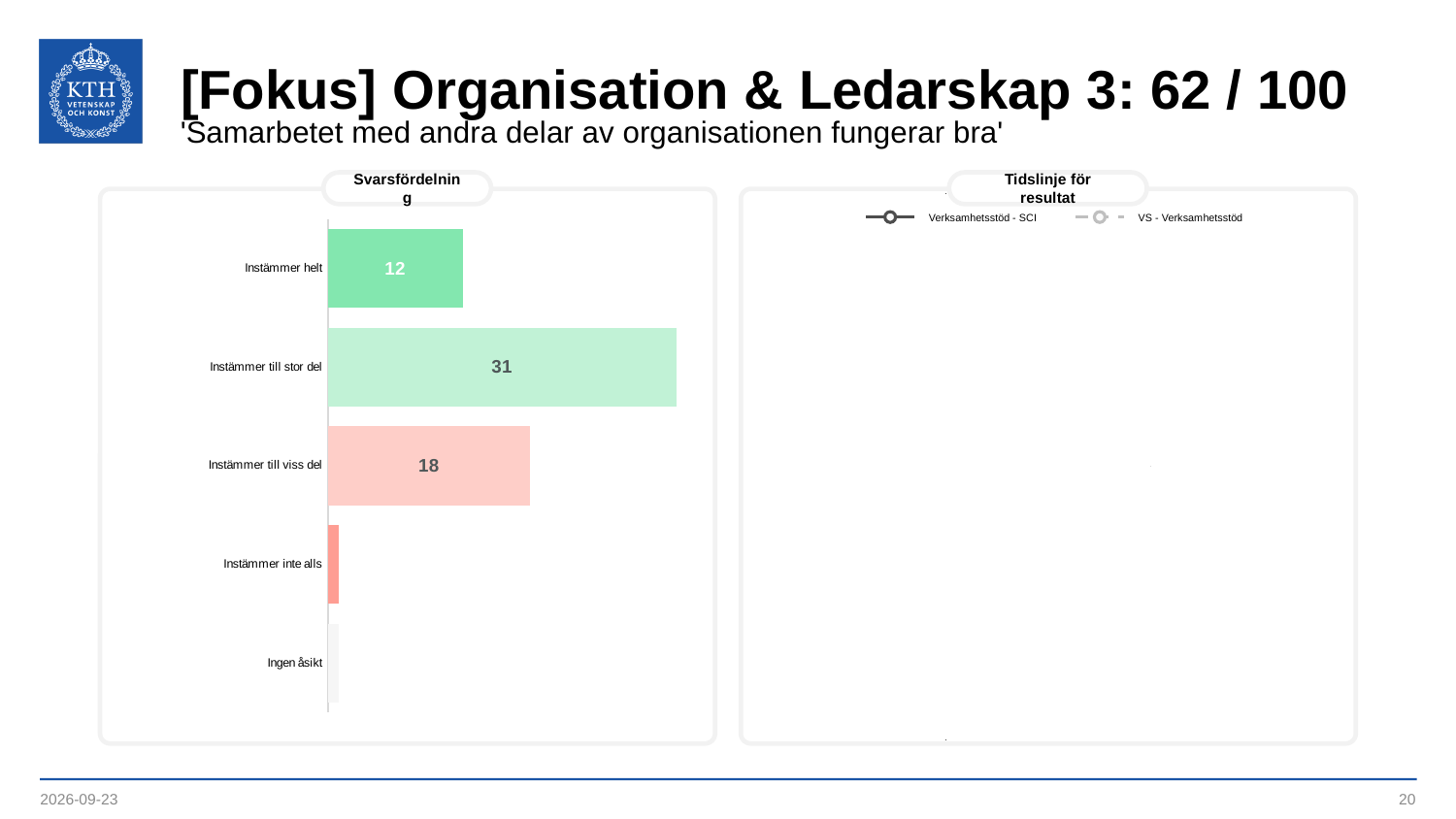
In the 'Svarsfördelning' chart, what is the value for 'Instämmer till stor del'? 31 How many categories are shown in the 'Svarsfördelning' chart? 5 In the 'Svarsfördelning' chart, what is the difference between 'Instämmer till viss del' and 'Instämmer helt'? 6 In the 'Svarsfördelning' chart, which is larger: 'Instämmer till viss del' or 'Instämmer helt'? Instämmer till viss del How many series does the legend of the 'Tidslinje för resultat' chart list? 2 In the 'Svarsfördelning' chart, what is the value for 'Instämmer till viss del'? 18 In the 'Svarsfördelning' chart, what is the value for 'Instämmer helt'? 12 In the 'Svarsfördelning' chart, which is larger: 'Instämmer till stor del' or 'Instämmer till viss del'? Instämmer till stor del What kind of chart is the 'Svarsfördelning' chart? Bar chart In the 'Svarsfördelning' chart, what is the difference between 'Instämmer till stor del' and 'Instämmer helt'? 19 In the 'Svarsfördelning' chart, which category has the highest value? Instämmer till stor del